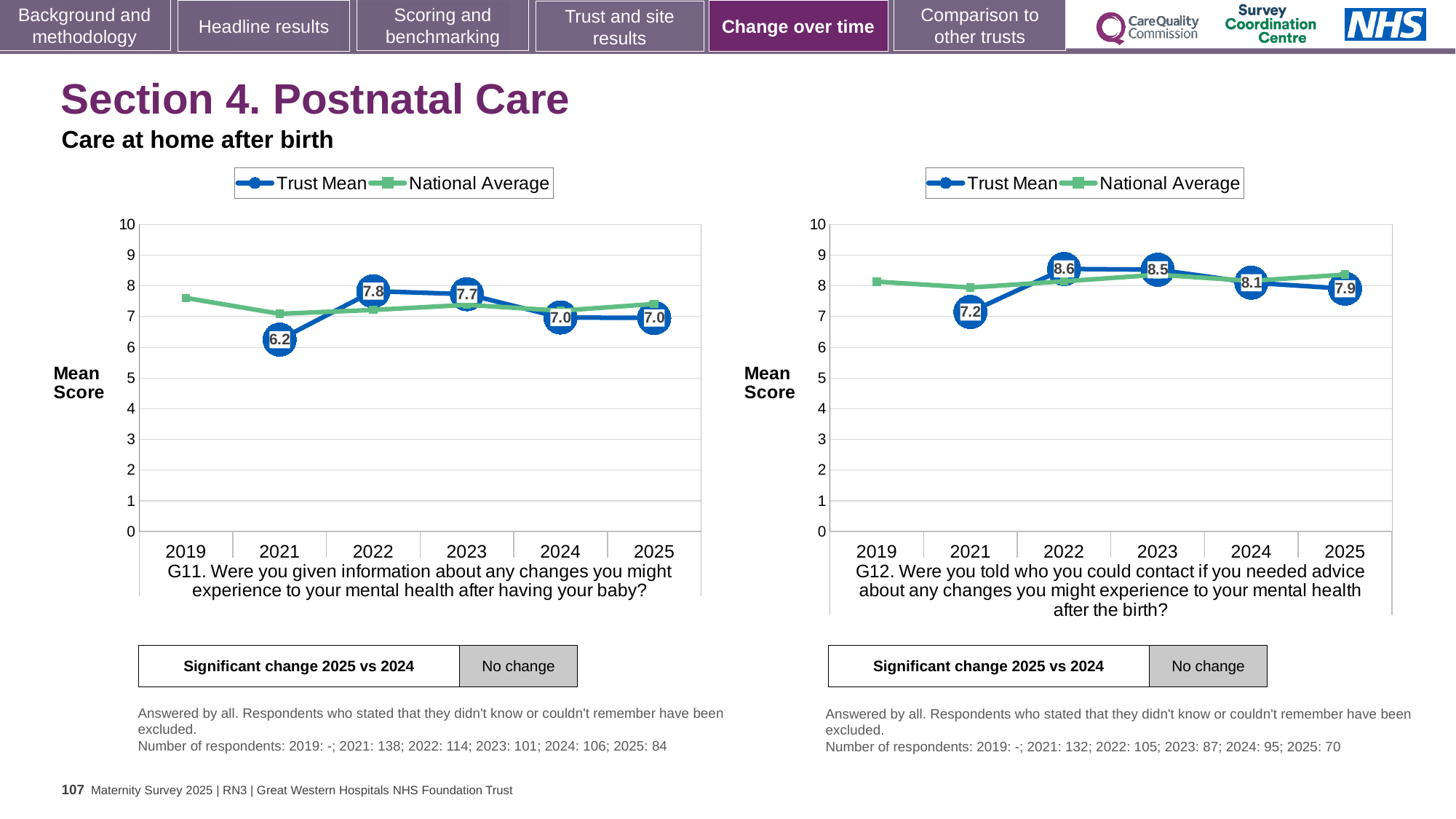
In the G12 chart on the right, does the Trust Mean rise or fall from 2022 to 2025? Fall In the G11 chart on the left, what is the Trust Mean score for 2022? 7.8 In the G11 chart on the left, what is the difference between the Trust Mean scores for 2022 and 2021? 1.6 What kind of chart is the G11 chart on the left? Line chart In the G12 chart on the right, which is larger, the Trust Mean score for 2021 or for 2024? 2024 In the G11 chart on the left, is the National Average for 2019 greater or less than 7? greater How many series does the legend of the G12 chart on the right list? 2 In the G11 chart on the left, what is the Trust Mean score for 2021? 6.2 In the G12 chart on the right, what is the Trust Mean score for 2025? 7.9 In the G11 chart on the left, which year has the lowest Trust Mean score? 2021 In the G12 chart on the right, which year has the highest Trust Mean score? 2022 In the G12 chart on the right, what is the difference between the Trust Mean scores for 2022 and 2025? 0.7